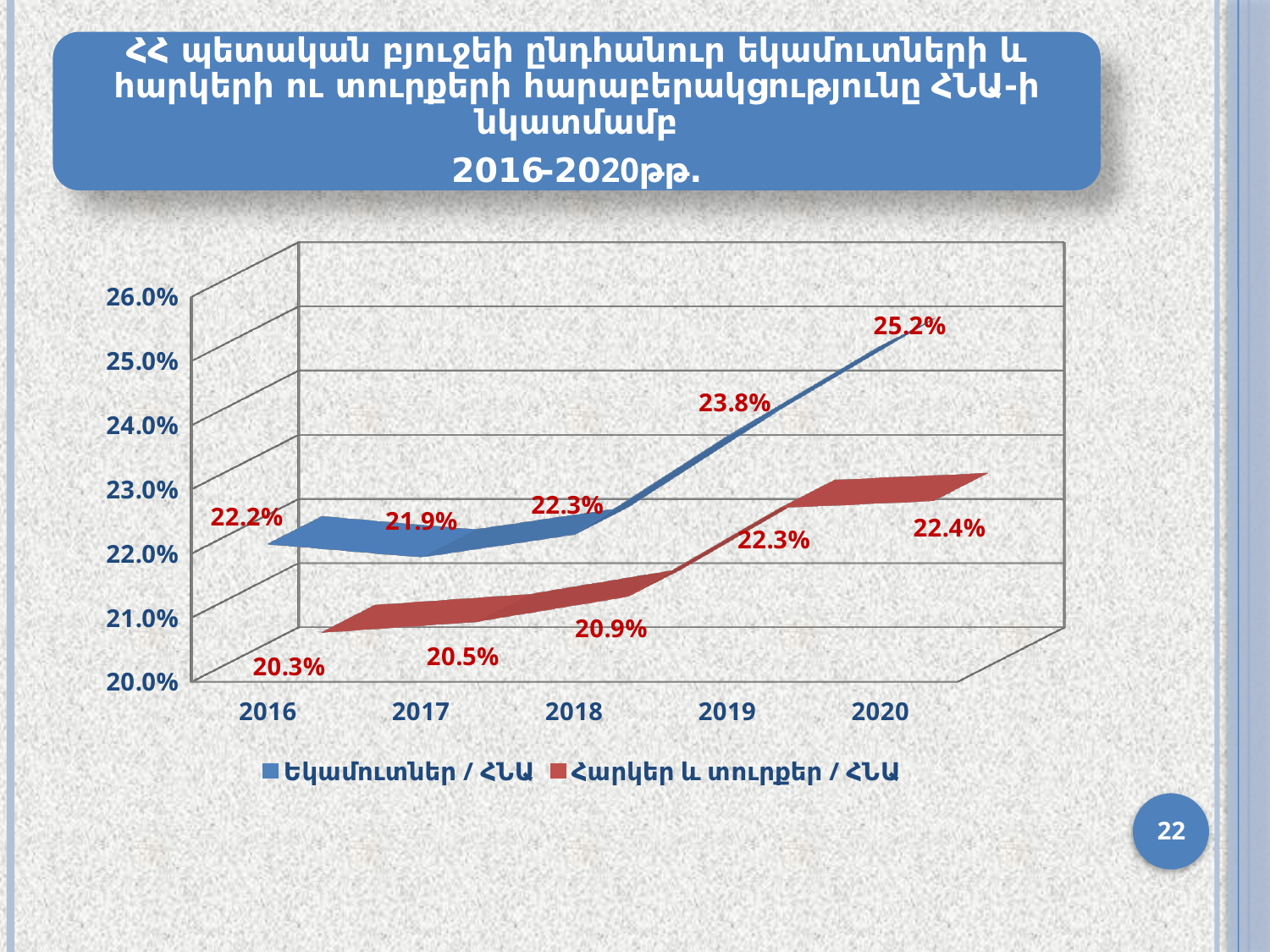
What is the difference between Եկամուտներ / ՀՆԱ and Հարկեր և տուրքեր / ՀՆԱ in 2020? 2.8% What is the value of Հարկեր և տուրքեր / ՀՆԱ in 2016? 20.3% What kind of chart is shown on the slide? Line chart In which year is Եկամուտներ / ՀՆԱ lowest? 2017 In which year is Հարկեր և տուրքեր / ՀՆԱ highest? 2020 What is the value of Եկամուտներ / ՀՆԱ in 2020? 25.2% What is the value of Հարկեր և տուրքեր / ՀՆԱ in 2019? 22.3% How many series does the legend list? 2 How many years are shown on the x axis? 5 Which series has the higher value in 2018, Եկամուտներ / ՀՆԱ or Հարկեր և տուրքեր / ՀՆԱ? Եկամուտներ / ՀՆԱ What is the value of Եկամուտներ / ՀՆԱ in 2017? 21.9% Does Հարկեր և տուրքեր / ՀՆԱ rise or fall from 2016 to 2020? Rise